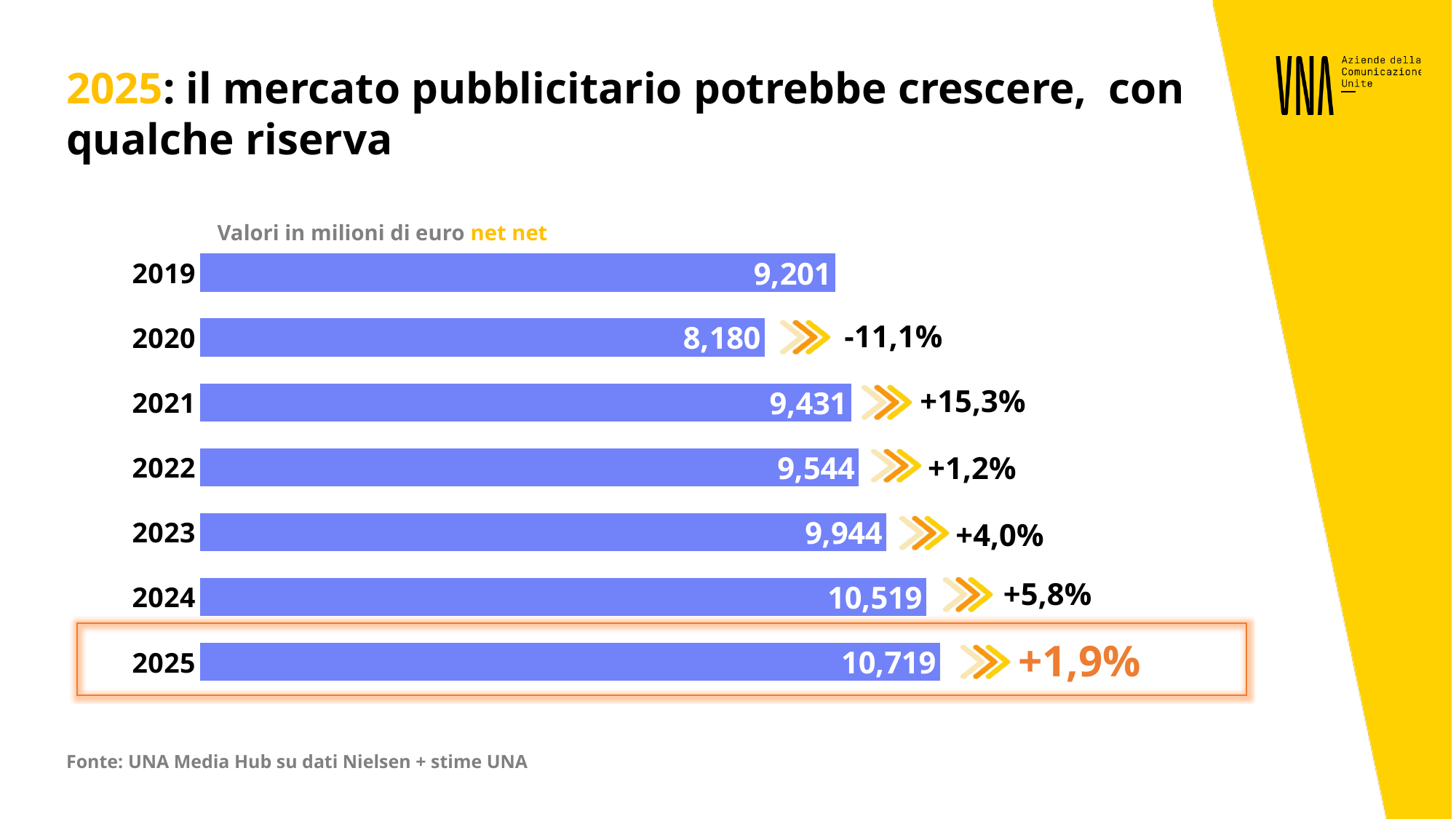
What kind of chart is shown on the slide? Bar chart What is the value for 2019? 9,201 Which is larger, the value for 2021 or the value for 2022? 2022 What percentage change is shown next to the 2021 bar? +15,3% How many years are shown in the chart? 7 Which year has the lowest value? 2020 Which year has the highest value? 2025 What is the difference between the values for 2019 and 2020? 1,021 What percentage change is shown next to the 2020 bar? -11,1% What is the difference between the values for 2025 and 2024? 200 Do the values rise or fall from 2020 to 2025? Rise What is the value for 2025? 10,719